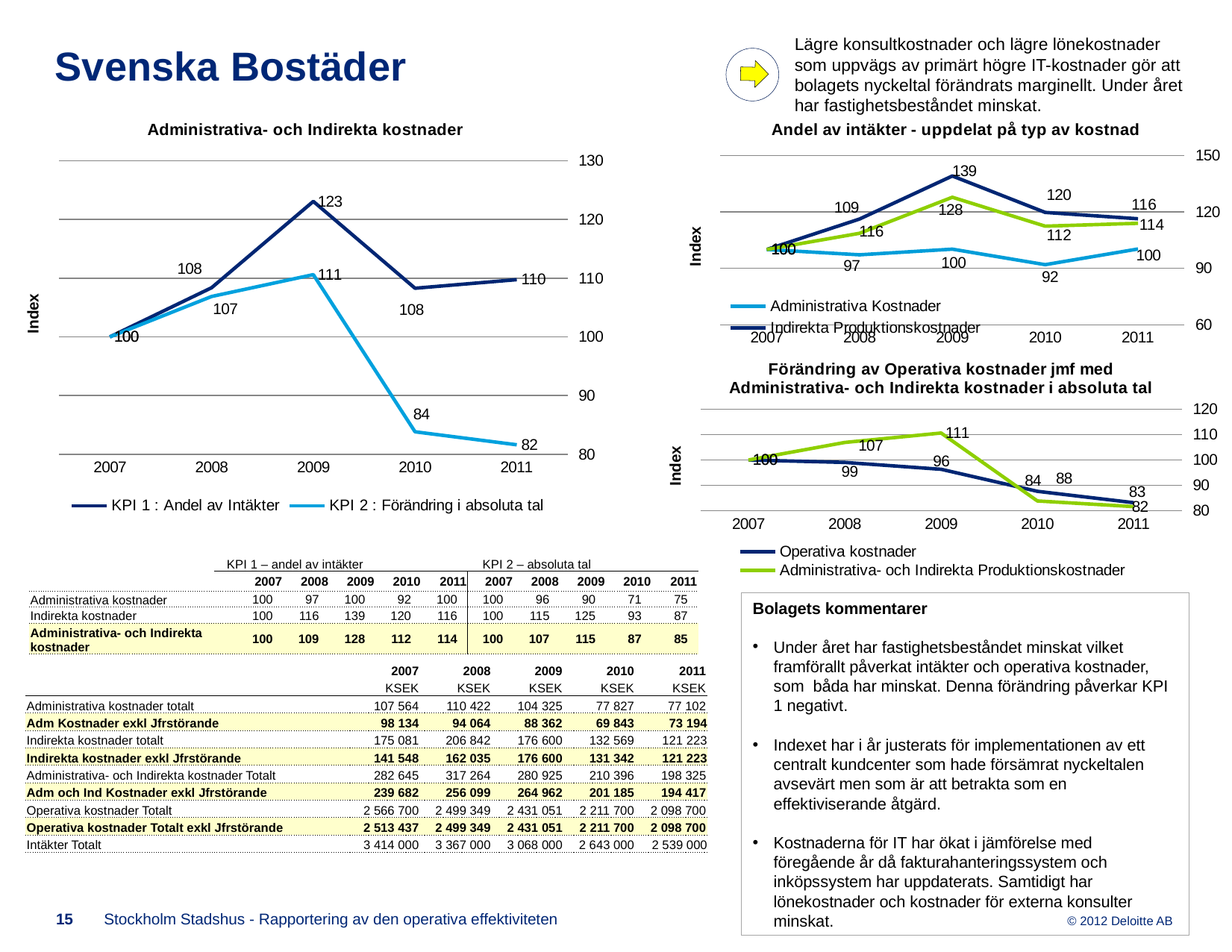
In the chart 'Förändring av Operativa kostnader jmf med Administrativa- och Indirekta kostnader i absoluta tal', which series has the higher value in 2009, Operativa kostnader or Administrativa- och Indirekta Produktionskostnader? Administrativa- och Indirekta Produktionskostnader In the chart 'Administrativa- och Indirekta kostnader', what is the value of KPI 1 : Andel av Intäkter in 2009? 123 In the chart 'Administrativa- och Indirekta kostnader', does KPI 2 : Förändring i absoluta tal rise or fall from 2009 to 2011? fall In the chart 'Förändring av Operativa kostnader jmf med Administrativa- och Indirekta kostnader i absoluta tal', what is the value of Operativa kostnader in 2011? 83 In the chart 'Administrativa- och Indirekta kostnader', what is the difference between KPI 1 and KPI 2 in 2010? 24 In the chart 'Andel av intäkter - uppdelat på typ av kostnad', what is the value of Indirekta Produktionskostnader in 2009? 139 How many years are shown on the x axis of the chart 'Förändring av Operativa kostnader jmf med Administrativa- och Indirekta kostnader i absoluta tal'? 5 In the chart 'Administrativa- och Indirekta kostnader', in which year does KPI 1 : Andel av Intäkter reach its highest value? 2009 In the chart 'Andel av intäkter - uppdelat på typ av kostnad', what is the lowest value of Administrativa Kostnader? 92 In the chart 'Administrativa- och Indirekta kostnader', how many series does the legend list? 2 What type of chart is 'Andel av intäkter - uppdelat på typ av kostnad'? line chart In the chart 'Administrativa- och Indirekta kostnader', what is the value of KPI 2 : Förändring i absoluta tal in 2011? 82